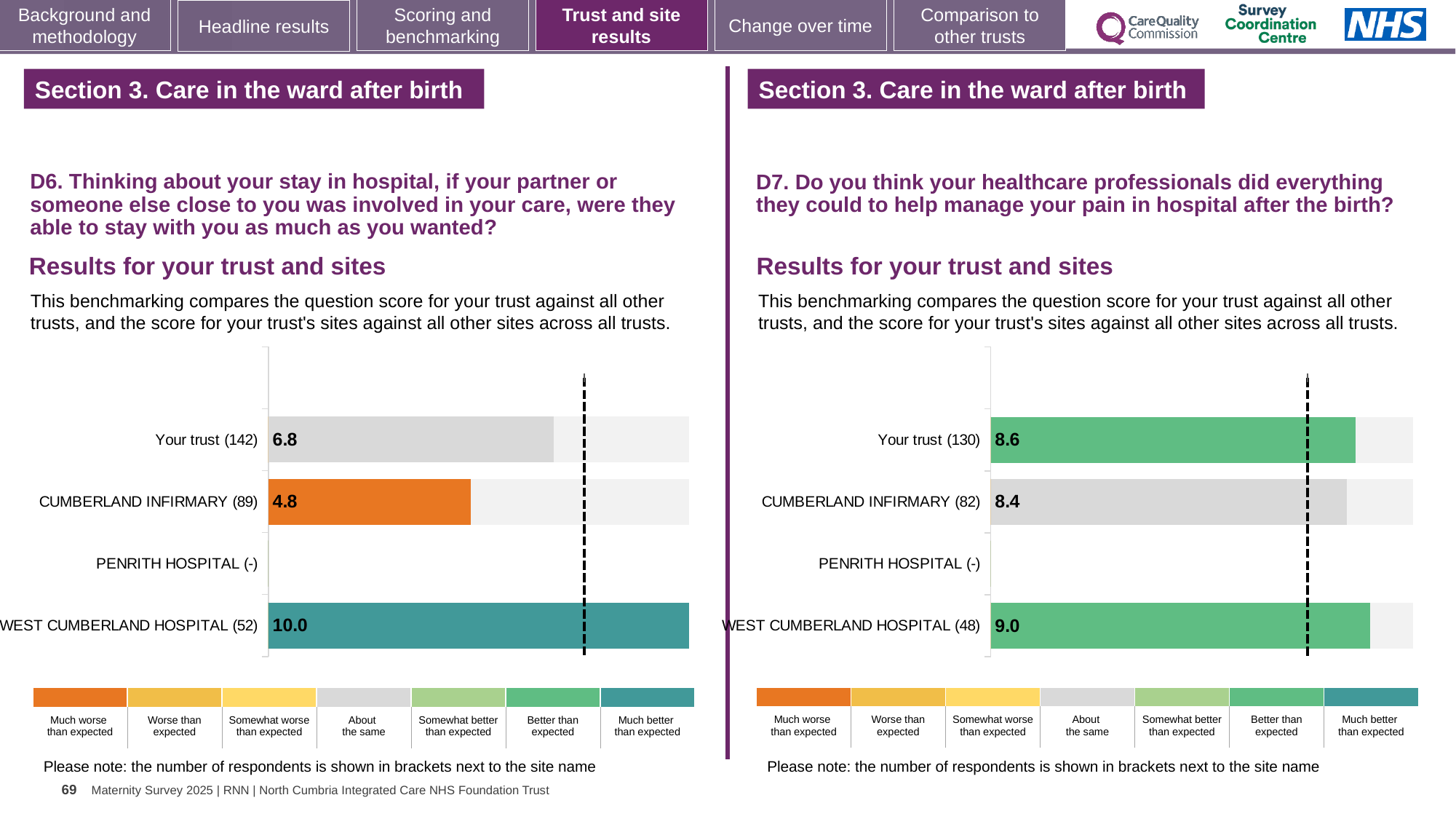
On the D7 chart (right), which has the higher score, CUMBERLAND INFIRMARY or WEST CUMBERLAND HOSPITAL? WEST CUMBERLAND HOSPITAL On the D7 chart (right), what is the difference between the scores for Your trust and CUMBERLAND INFIRMARY? 0.2 On the D7 chart (right), what is the score for Your trust? 8.6 On the D6 chart (left), which benchmark category does the colour of the CUMBERLAND INFIRMARY bar correspond to? Much worse than expected On the D6 chart (left), what is the difference between the scores for WEST CUMBERLAND HOSPITAL and CUMBERLAND INFIRMARY? 5.2 On the D7 chart (right), what is the score for WEST CUMBERLAND HOSPITAL? 9.0 On the D7 chart (right), how many respondents are shown in brackets for Your trust? 130 On the D6 chart (left), what is the score for Your trust? 6.8 On the D6 chart (left), what is the score for CUMBERLAND INFIRMARY? 4.8 What kind of chart is the D6 chart (left)? Bar chart On the D6 chart (left), what is the score for WEST CUMBERLAND HOSPITAL? 10.0 On the D6 chart (left), which site has the highest score? WEST CUMBERLAND HOSPITAL